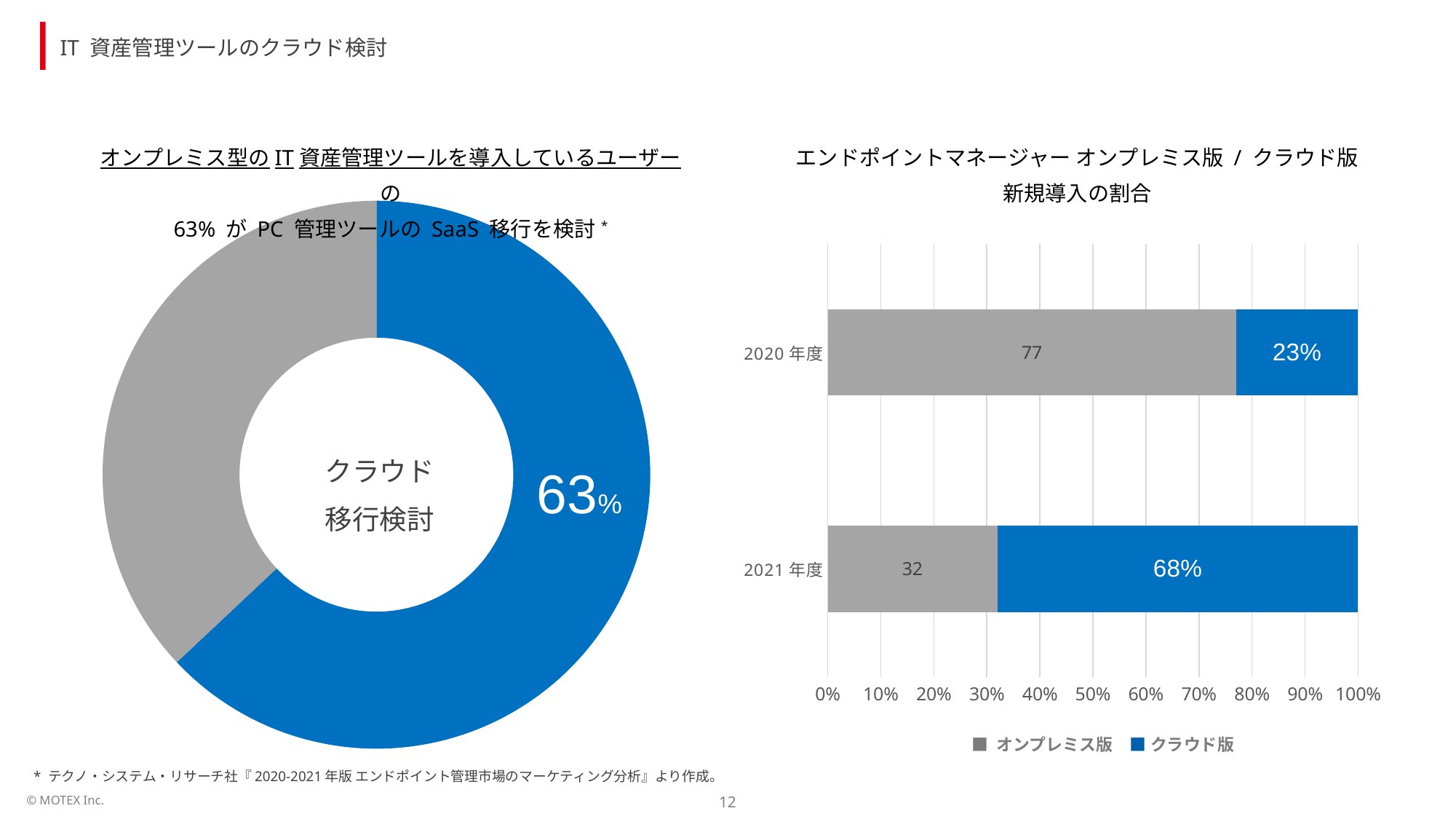
What kind of chart is the chart on the right side of the slide? Stacked bar chart In the right-hand bar chart, what is the value labelled on the オンプレミス版 segment for 2021 年度? 32 In the right-hand bar chart, what is the value for クラウド版 in 2021 年度? 68% How many categories (years) are shown in the right-hand bar chart? 2 In the right-hand bar chart, what is the value labelled on the オンプレミス版 segment for 2020 年度? 77 In the right-hand bar chart, which year has the higher クラウド版 share, 2020 年度 or 2021 年度? 2021 年度 In the donut chart on the left, what percentage is shown for クラウド移行検討? 63% What kind of chart is the chart on the left side of the slide? Donut (pie) chart In the right-hand bar chart, by how many percentage points did the クラウド版 share increase from 2020 年度 to 2021 年度? 45 In the right-hand bar chart, which colour represents クラウド版? Blue In the right-hand bar chart, what is the value for クラウド版 in 2020 年度? 23% How many series does the legend of the right-hand bar chart list? 2